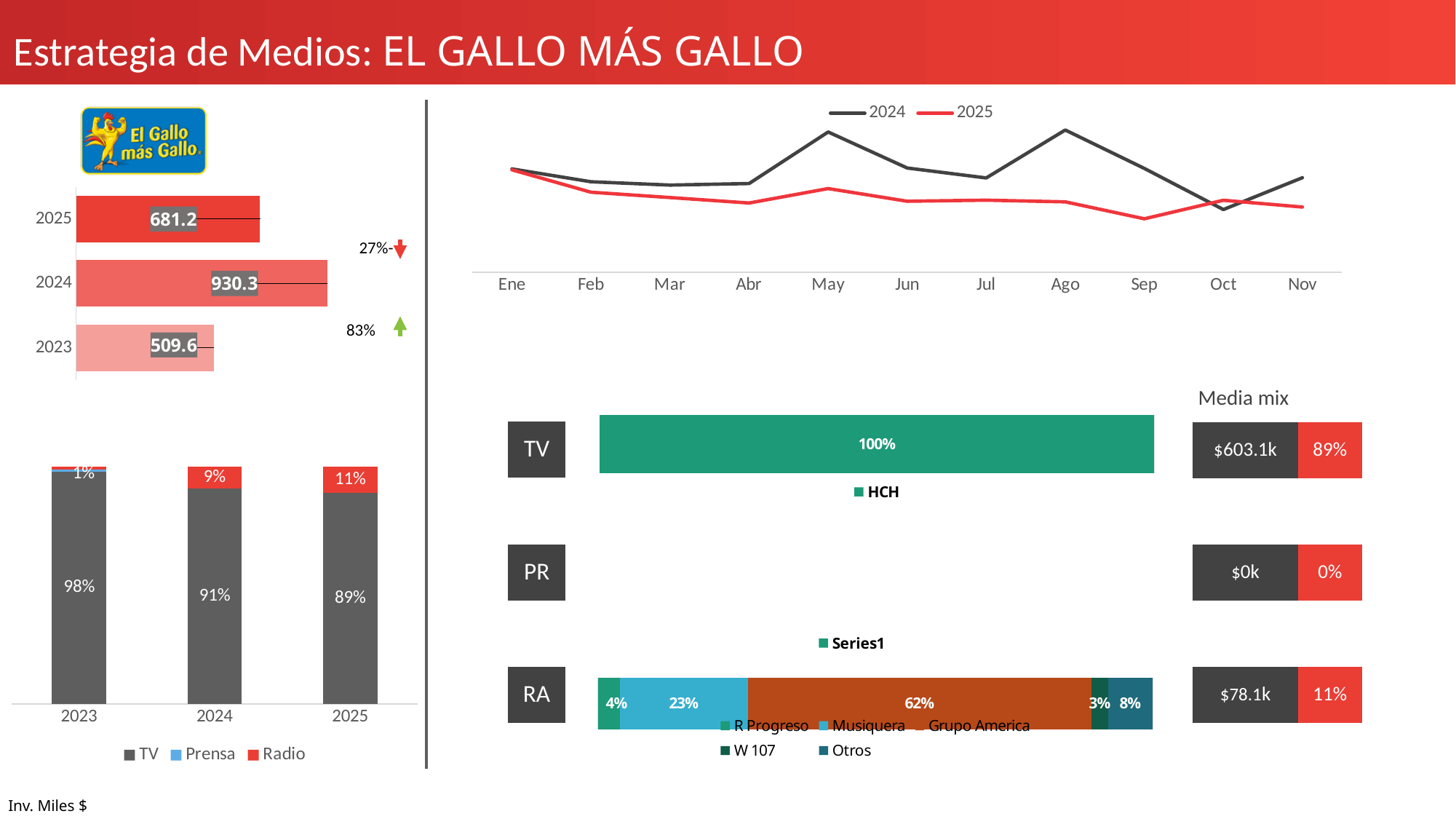
In the horizontal bar chart on the left showing yearly investment, which year has the lowest value? 2023 In the stacked bar chart at the bottom left, what is the TV share for 2025? 89% In the horizontal bar chart on the left showing yearly investment, what is the value for 2024? 930.3 In the stacked bar chart at the bottom left, does the TV share rise or fall from 2023 to 2025? fall In the Media mix table at the bottom right, what is the amount shown for TV? $603.1k In the horizontal bar chart on the left showing yearly investment, what is the difference between the 2024 and 2025 values? 249.1 How many series does the legend of the stacked bar chart at the bottom left list? 3 In the RA bar at the bottom right, what share does Grupo America have? 62% In the stacked bar chart at the bottom left, what is the Radio share for 2024? 9% In the horizontal bar chart on the left showing yearly investment, which year has the highest value? 2024 How many months are shown on the x axis of the line chart at the top right? 11 In the line chart at the top right, which series is higher in May, 2024 or 2025? 2024